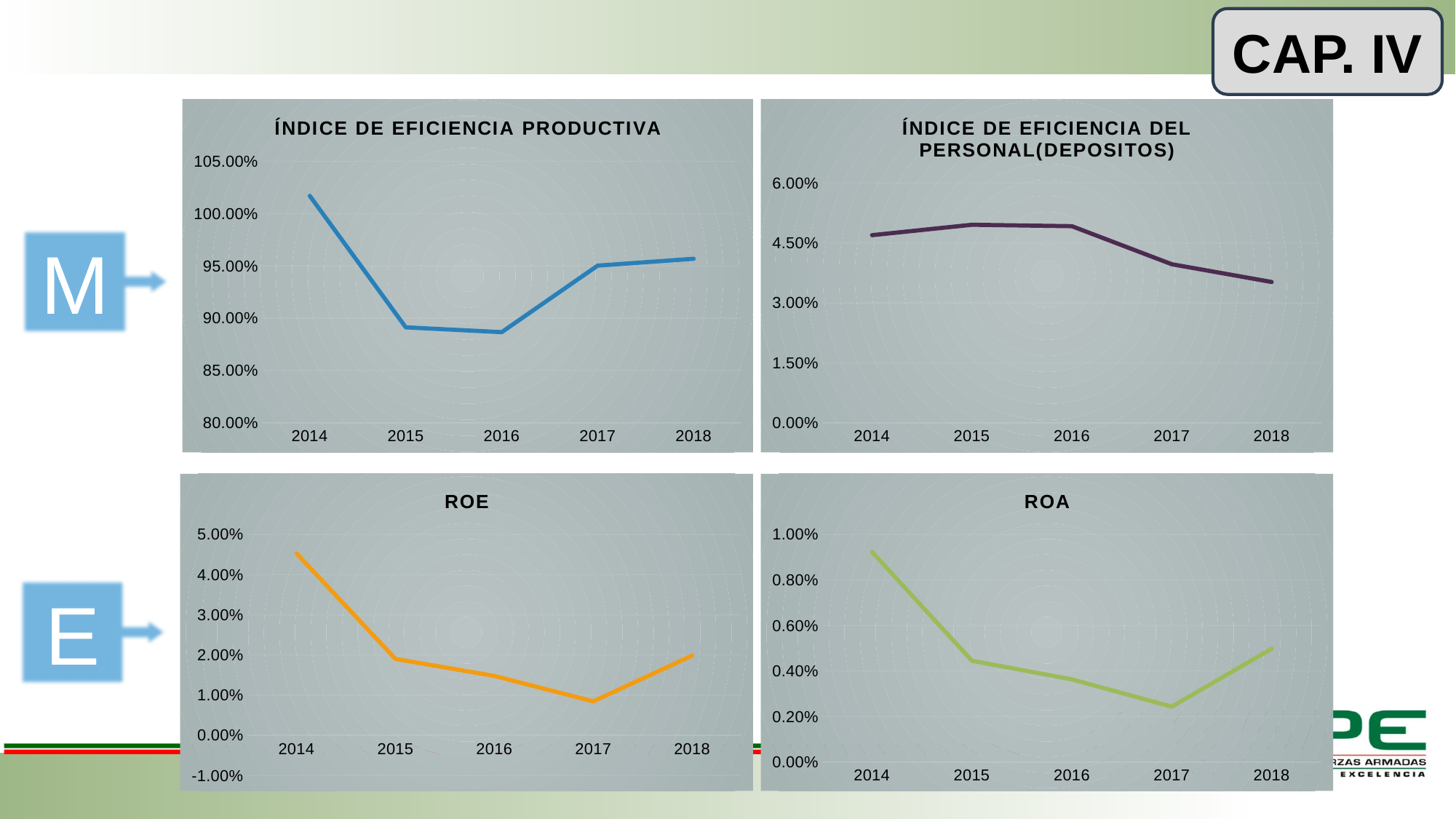
In the ROE chart, which year has the lowest value? 2017 What kind of chart is the ROE chart? line chart In the ROE chart, is the value for 2014 greater or less than 4.00%? greater In the ÍNDICE DE EFICIENCIA PRODUCTIVA chart, is the value for 2014 greater or less than 100.00%? greater In the ROA chart, which year has the highest value? 2014 In the ÍNDICE DE EFICIENCIA PRODUCTIVA chart, is the value for 2015 greater or less than 90.00%? less How many years are plotted on the ÍNDICE DE EFICIENCIA PRODUCTIVA chart? 5 In the ÍNDICE DE EFICIENCIA DEL PERSONAL(DEPOSITOS) chart, do the values rise or fall from 2016 to 2018? fall In the ÍNDICE DE EFICIENCIA PRODUCTIVA chart, which year has the highest value? 2014 In the ÍNDICE DE EFICIENCIA DEL PERSONAL(DEPOSITOS) chart, which year has the lowest value? 2018